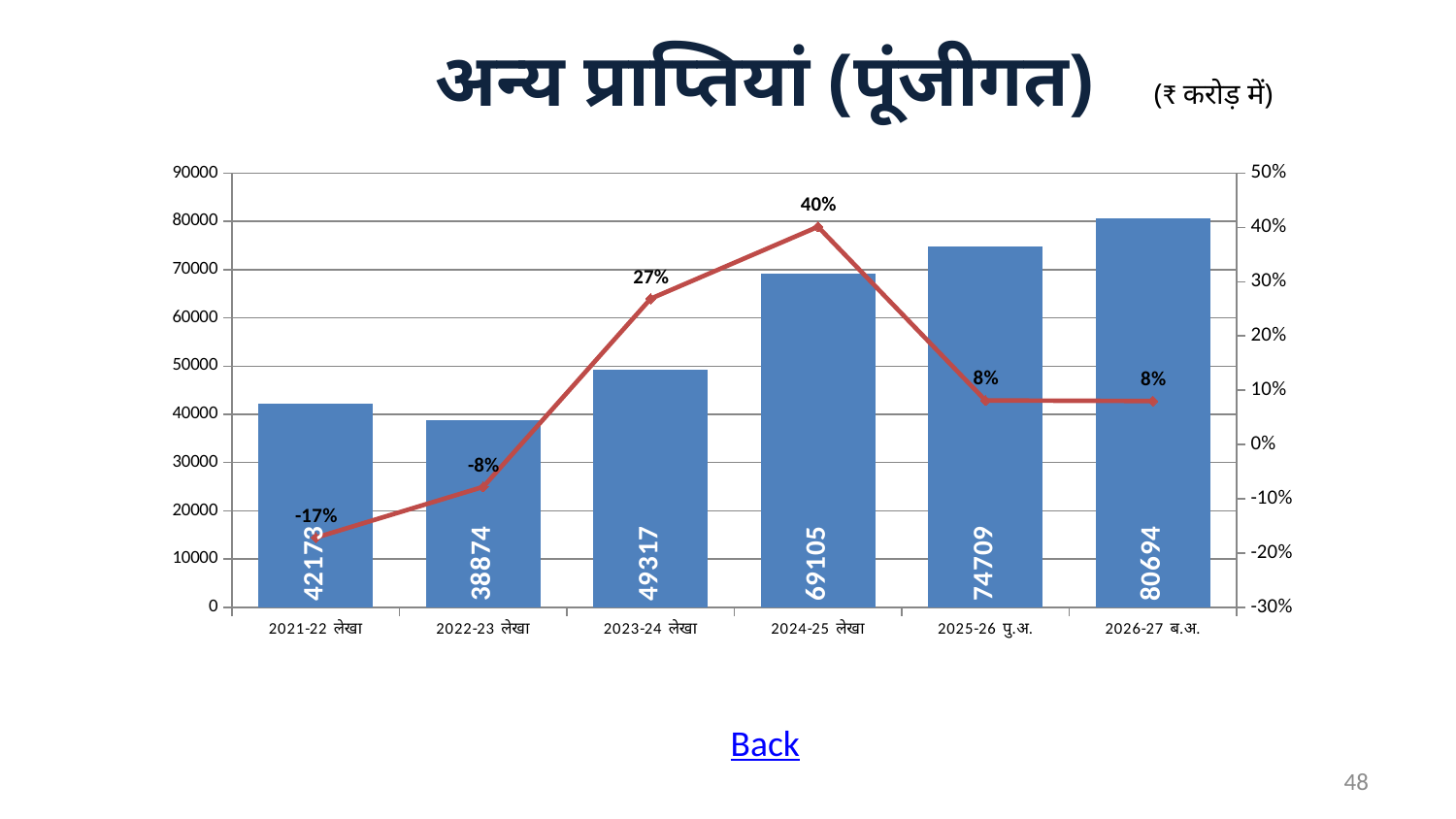
Do the bar values rise or fall from 2022-23 लेखा to 2026-27 ब.अ.? rise What is the bar value for 2022-23 लेखा? 38874 How many categories are shown on the x axis? 6 What growth percentage is shown on the line for 2021-22 लेखा? -17% Which category has the highest growth percentage on the line? 2024-25 लेखा Which category has the highest bar value? 2026-27 ब.अ. What growth percentage is shown on the line for 2023-24 लेखा? 27% What is the bar value for 2024-25 लेखा? 69105 What is the difference between the bar values for 2026-27 ब.अ. and 2025-26 पु.अ.? 5985 Which category has the lowest bar value? 2022-23 लेखा What unit is stated next to the chart title? ₹ करोड़ में Which is larger, the bar value for 2023-24 लेखा or for 2021-22 लेखा? 2023-24 लेखा